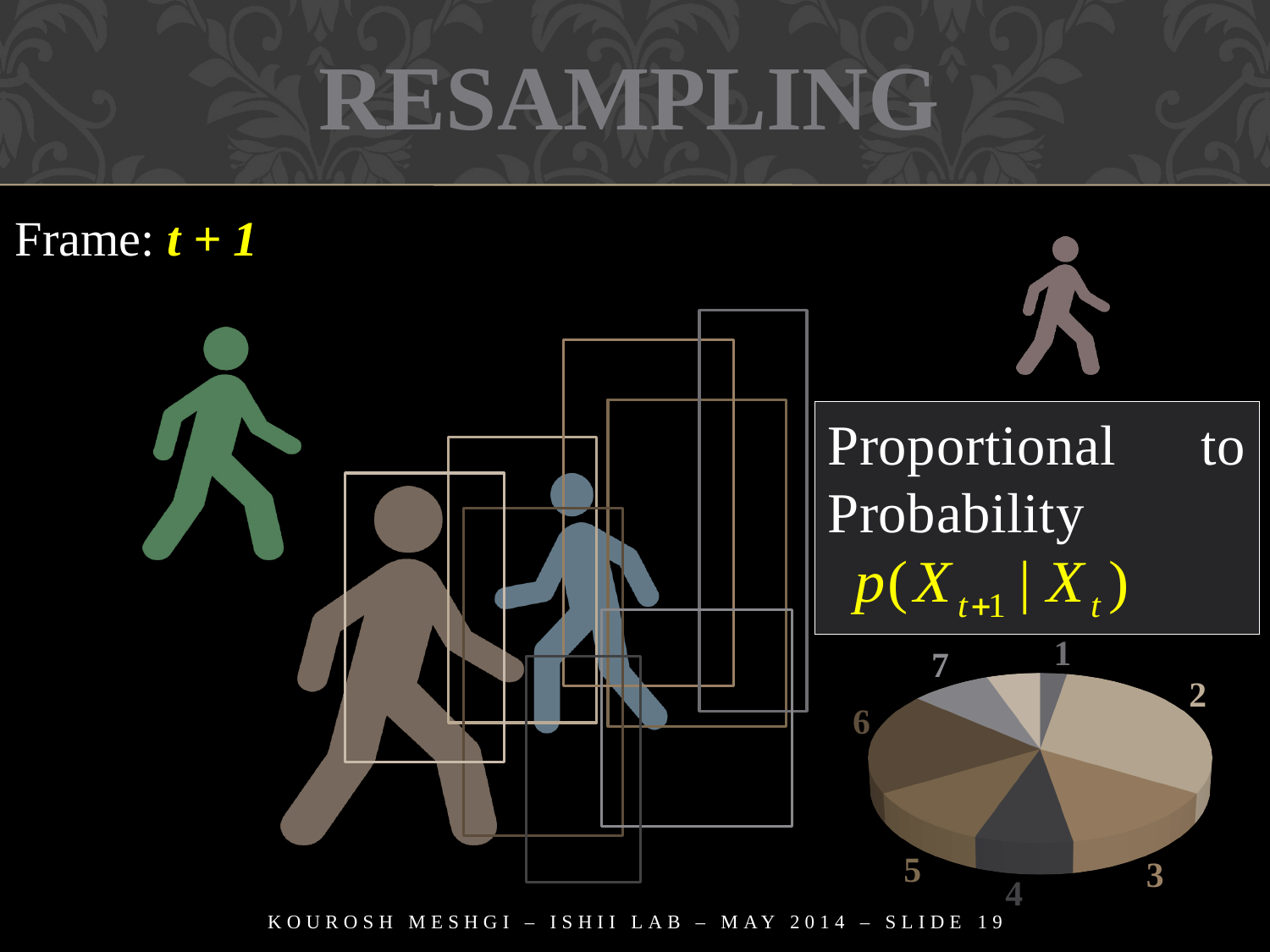
Which slice of the pie chart is the largest? 2 Is the pie chart drawn in 3D or flat 2D? 3D In the pie chart, which slice is larger, slice 1 or slice 5? 5 In the pie chart, which slice is larger, slice 2 or slice 1? 2 What labels are used for the slices of the pie chart? 1 to 7 Which slice of the pie chart is the smallest? 1 In the pie chart, which slice is larger, slice 3 or slice 7? 3 How many slices does the pie chart have? 8 What kind of chart is shown on the slide? pie chart